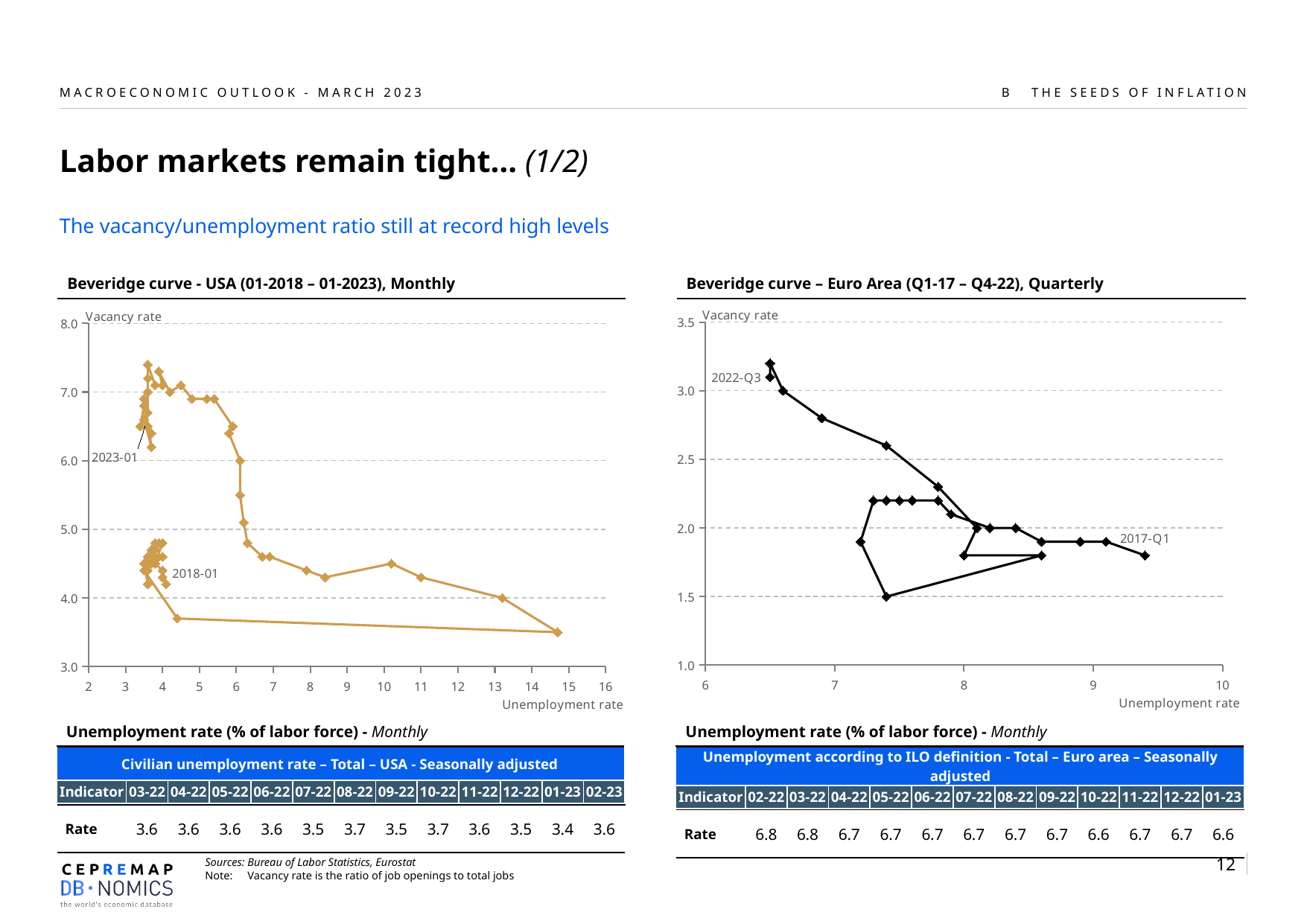
In the Beveridge curve - USA chart, is the vacancy rate at the point labelled 2018-01 greater or less than 5.0? less In the Beveridge curve - USA chart, is the highest unemployment rate reached by the curve greater or less than 14? greater In the Beveridge curve - Euro Area chart, is the vacancy rate at the point labelled 2022-Q3 greater or less than 3.0? greater What is the label of the horizontal axis in the Beveridge curve - USA chart? Unemployment rate What kind of chart is the Beveridge curve - USA chart on the left? line chart In the Beveridge curve - Euro Area chart, which labelled point has the higher vacancy rate, 2022-Q3 or 2017-Q1? 2022-Q3 What is the data frequency stated in the title of the Beveridge curve - Euro Area chart? Quarterly In the Beveridge curve - USA chart, which labelled point has the higher vacancy rate, 2023-01 or 2018-01? 2023-01